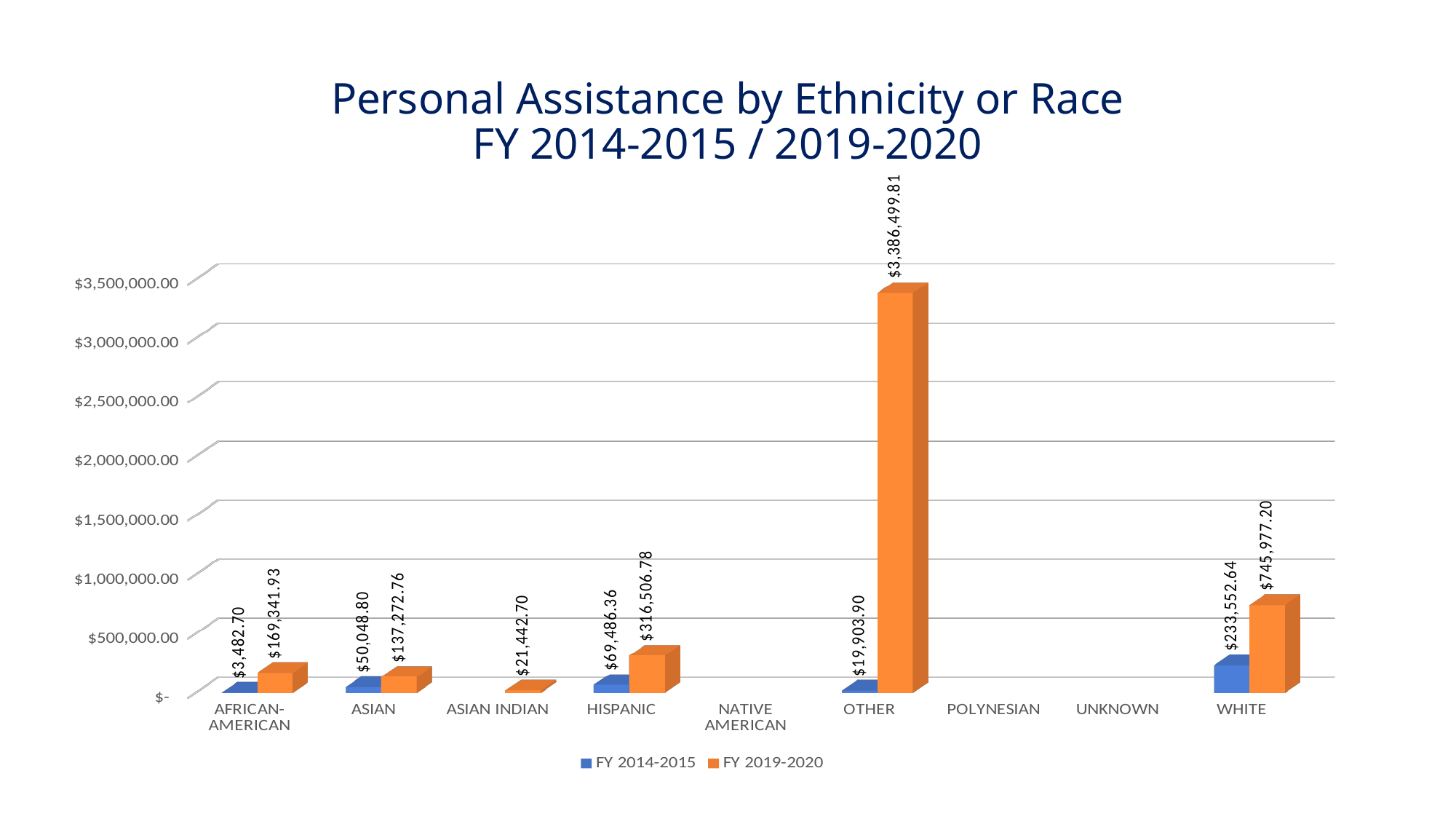
Which category has the highest FY 2014-2015 value? White Is the FY 2019-2020 value for Other greater or less than $3,000,000.00? greater What is the difference between the FY 2019-2020 and FY 2014-2015 values for White? $512,424.56 What is the FY 2019-2020 value for Asian Indian? $21,442.70 What is the FY 2014-2015 value for White? $233,552.64 How many series does the legend list? 2 What type of chart is shown on the slide? Bar chart Which category has the highest FY 2019-2020 value? Other What is the FY 2019-2020 value for Other? $3,386,499.81 What is the FY 2014-2015 value for African-American? $3,482.70 How many ethnicity or race categories are shown on the x axis? 9 Which is larger for Hispanic: the FY 2014-2015 value or the FY 2019-2020 value? FY 2019-2020